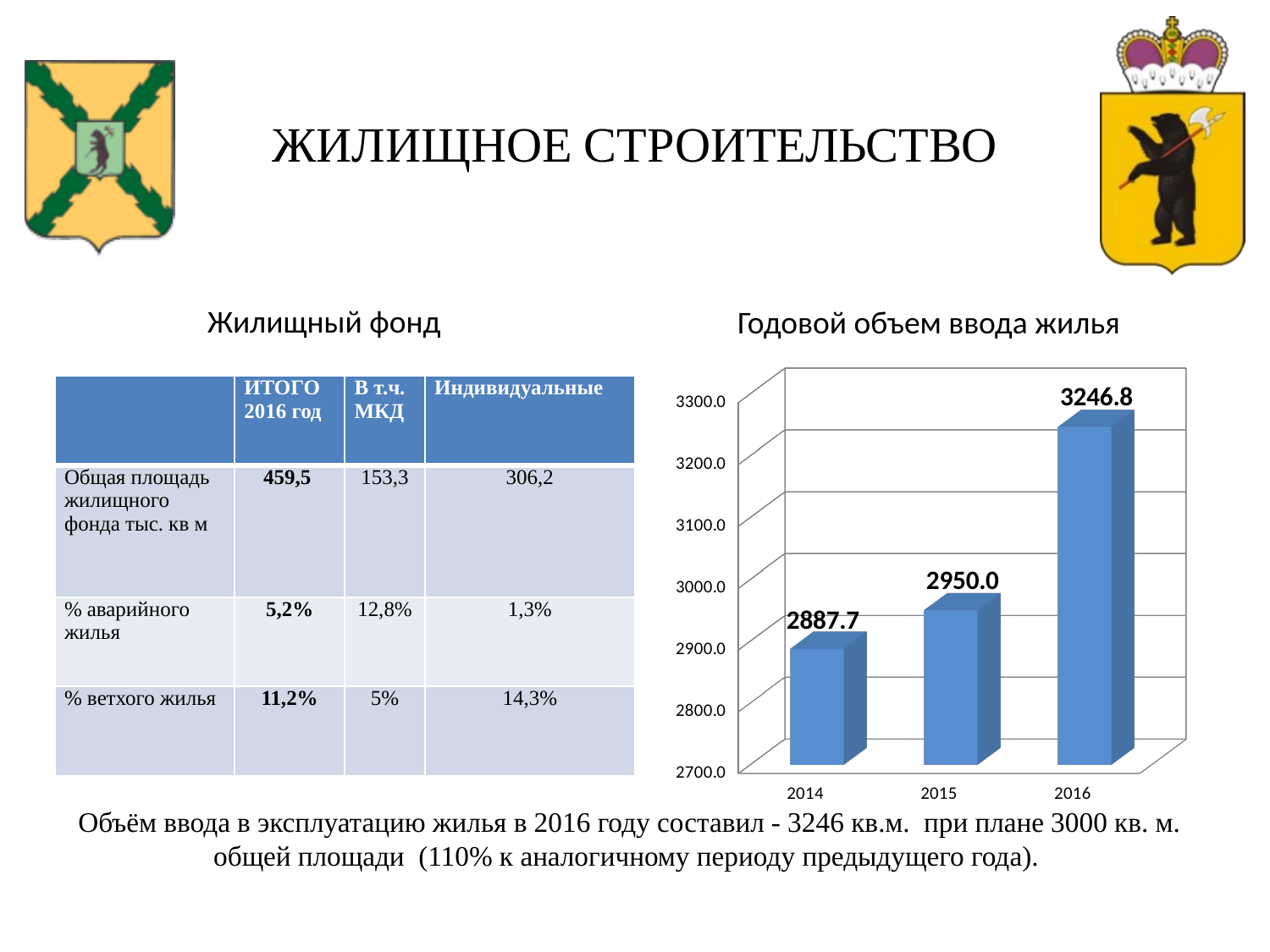
In the chart "Годовой объем ввода жилья", which is larger, the value for 2015 or the value for 2014? 2015 What is the difference between the 2015 and 2014 values in the chart "Годовой объем ввода жилья"? 62.3 What is the difference between the 2016 and 2015 values in the chart "Годовой объем ввода жилья"? 296.8 Do the values in the chart "Годовой объем ввода жилья" rise or fall from 2014 to 2016? rise How many years are shown in the chart "Годовой объем ввода жилья"? 3 What is the value for 2016 in the chart "Годовой объем ввода жилья"? 3246.8 Which year has the lowest value in the chart "Годовой объем ввода жилья"? 2014 What is the value for 2014 in the chart "Годовой объем ввода жилья"? 2887.7 What is the value for 2015 in the chart "Годовой объем ввода жилья"? 2950.0 In the chart "Годовой объем ввода жилья", is the value for 2016 greater or less than 3200.0? greater Which year has the highest value in the chart "Годовой объем ввода жилья"? 2016 What kind of chart is "Годовой объем ввода жилья"? bar chart